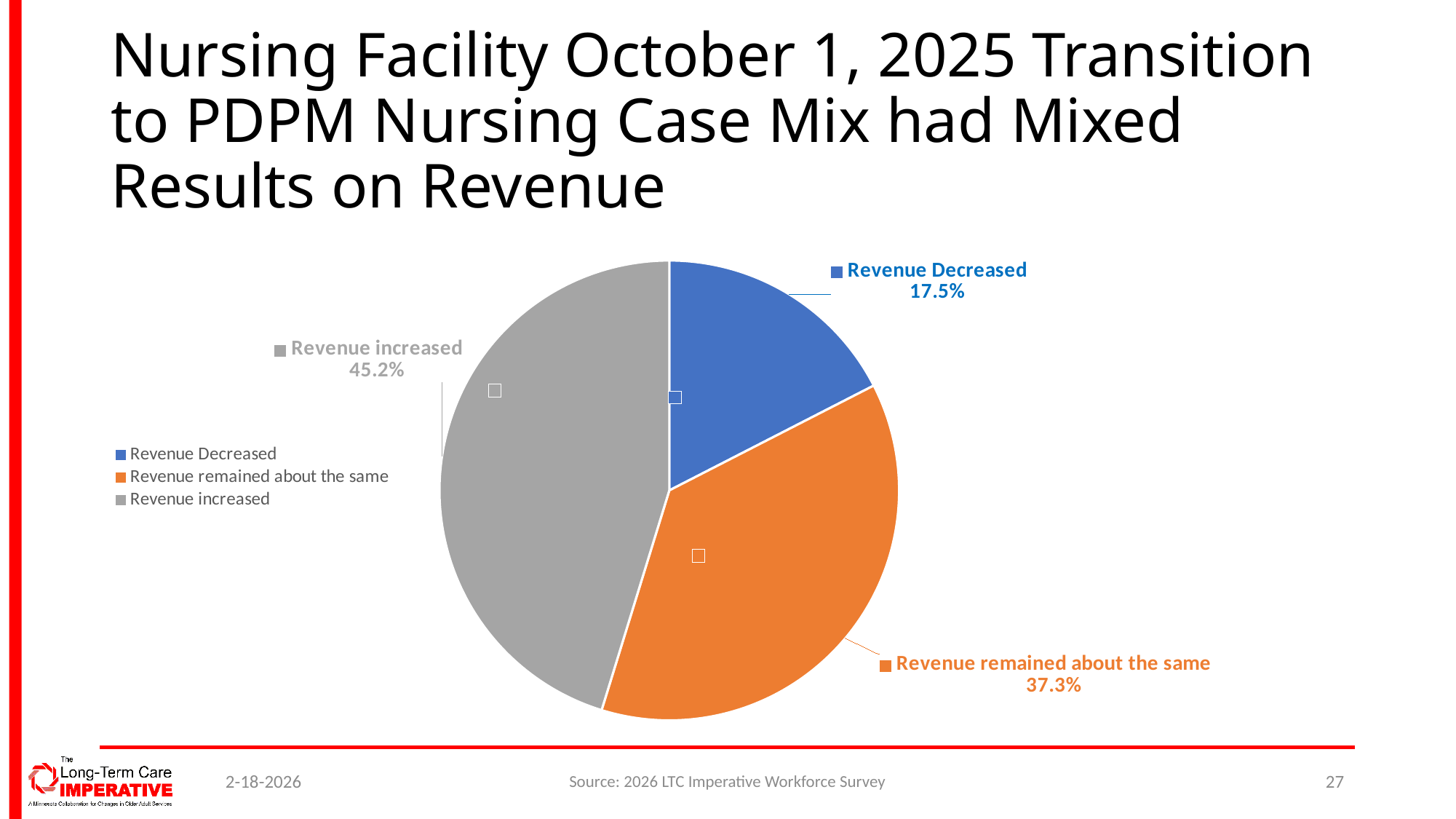
What share of the pie is labelled "Revenue increased"? 45.2% What colour is the "Revenue remained about the same" slice? orange Which slice of the pie is the smallest? Revenue Decreased What share of the pie is labelled "Revenue remained about the same"? 37.3% What is the difference in percentage points between the "Revenue increased" slice and the "Revenue remained about the same" slice? 7.9 What is the difference in percentage points between the "Revenue increased" slice and the "Revenue Decreased" slice? 27.7 How many entries does the legend list? 3 How many slices does the pie chart have? 3 Which slice of the pie is the largest? Revenue increased What share of the pie is labelled "Revenue Decreased"? 17.5% Which is larger: the share for "Revenue remained about the same" or the share for "Revenue Decreased"? Revenue remained about the same What kind of chart is shown on the slide? pie chart